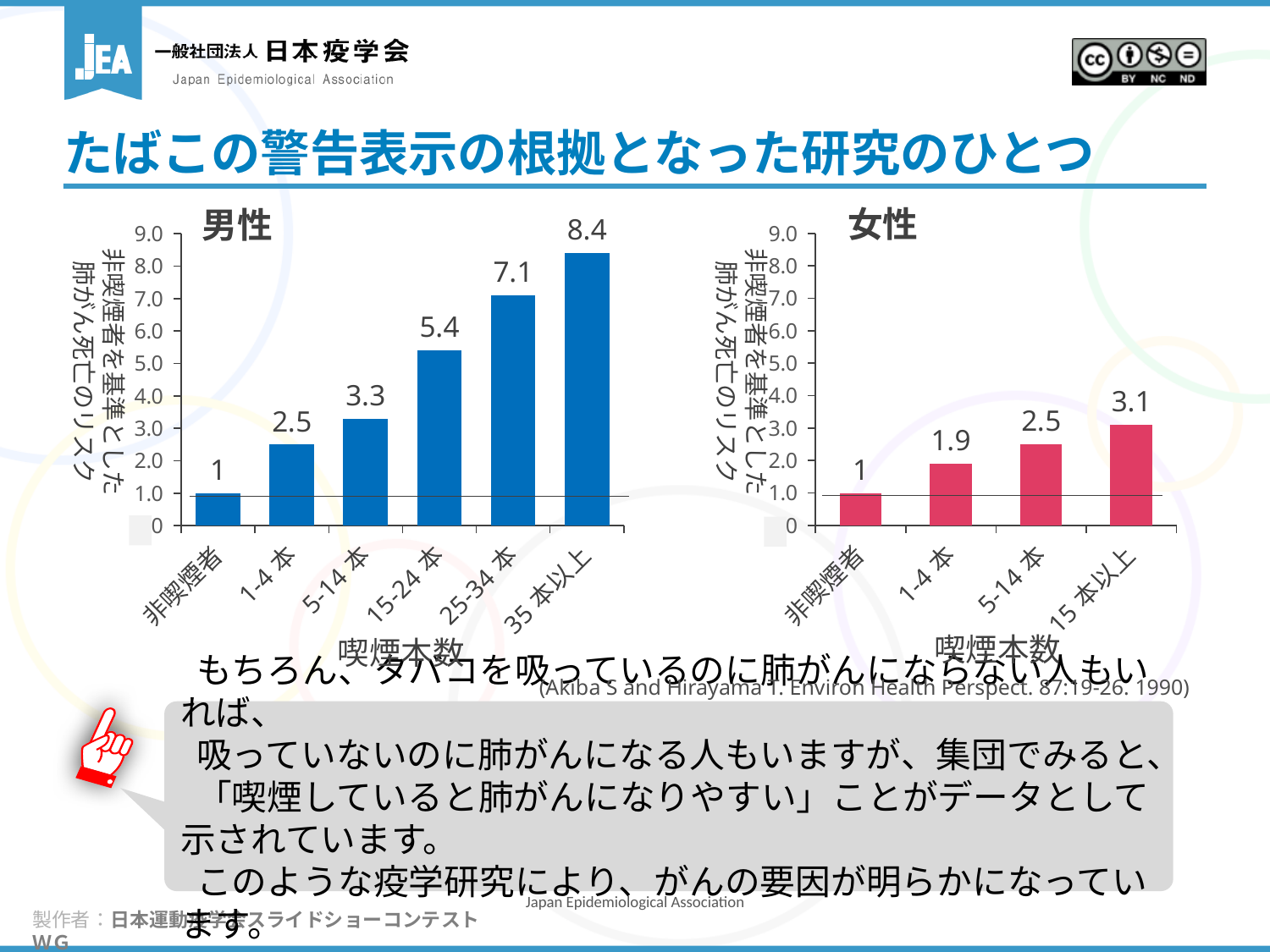
Which is larger: the value for 5-14本 in the 男性 chart or the value for 5-14本 in the 女性 chart? 男性 chart In the 男性 chart, which category has the lowest value? 非喫煙者 In the 女性 chart, what is the difference between the values for 15本以上 and 非喫煙者? 2.1 How many categories are shown in the 女性 chart? 4 In the 男性 chart, do the values rise or fall as the number of cigarettes increases along the x axis? Rise In the 男性 chart, what is the value for 35本以上? 8.4 In the 男性 chart, what is the value for 15-24本? 5.4 In the 男性 chart, what is the difference between the values for 35本以上 and 25-34本? 1.3 What kind of chart is the 女性 chart? Bar chart How many categories are shown in the 男性 chart? 6 In the 女性 chart, which category has the highest value? 15本以上 In the 女性 chart, what is the value for 1-4本? 1.9